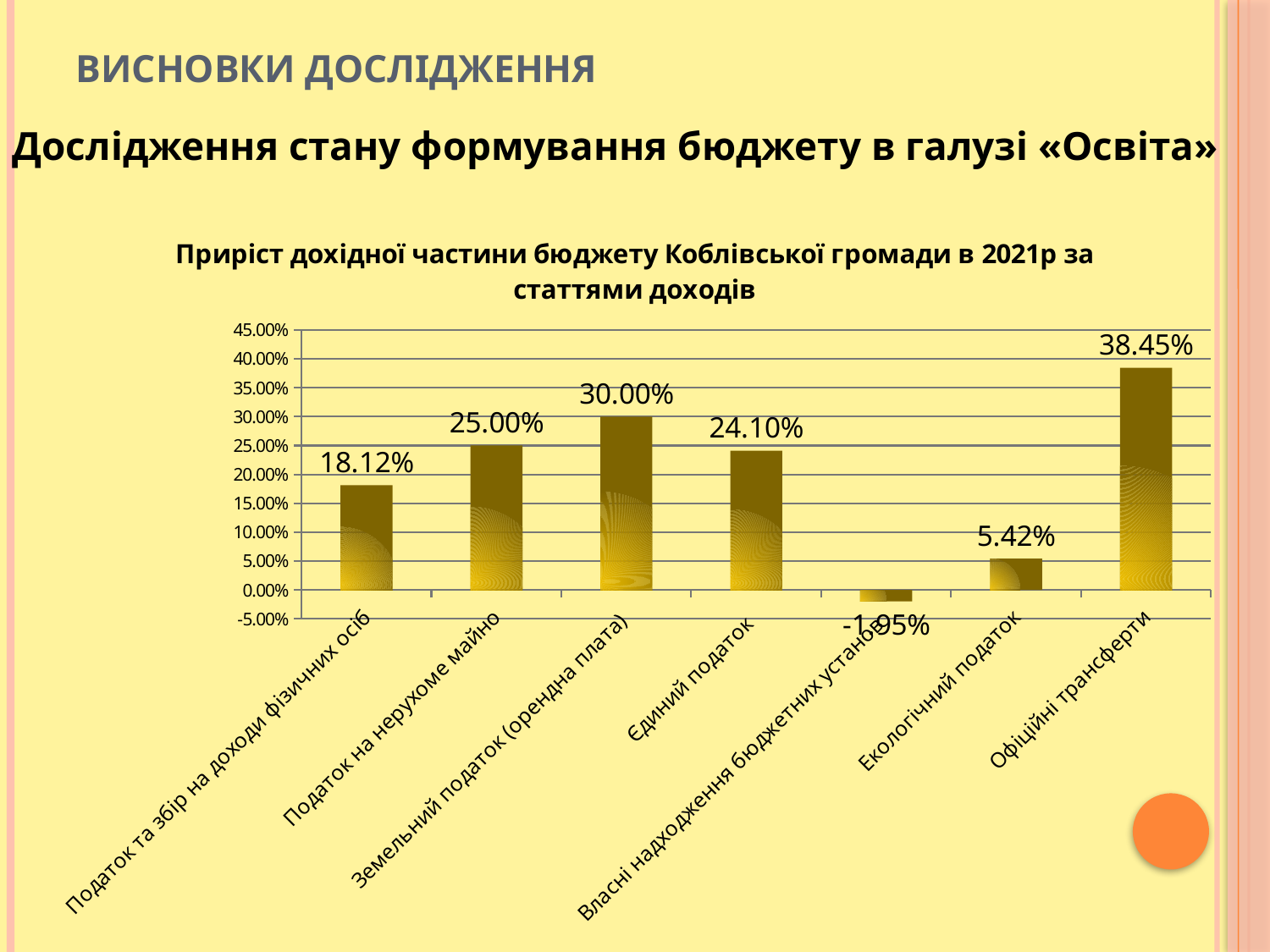
What is the value for Єдиний податок? 24.10% Which category has the lowest value? Власні надходження бюджетних установ What is the difference between the values for Офіційні трансферти and Земельний податок (орендна плата)? 8.45% What is the value for Земельний податок (орендна плата)? 30.00% What is the value for Офіційні трансферти? 38.45% Which is larger, the value for Податок на нерухоме майно or the value for Єдиний податок? Податок на нерухоме майно What type of chart is shown on the slide? Bar chart Is the value for Податок та збір на доходи фізичних осіб greater or less than 20.00%? less Which category has the highest value? Офіційні трансферти How many categories are shown on the x axis? 7 What is the value for Екологічний податок? 5.42% What is the title of the chart? Приріст дохідної частини бюджету Коблівської громади в 2021р за статтями доходів